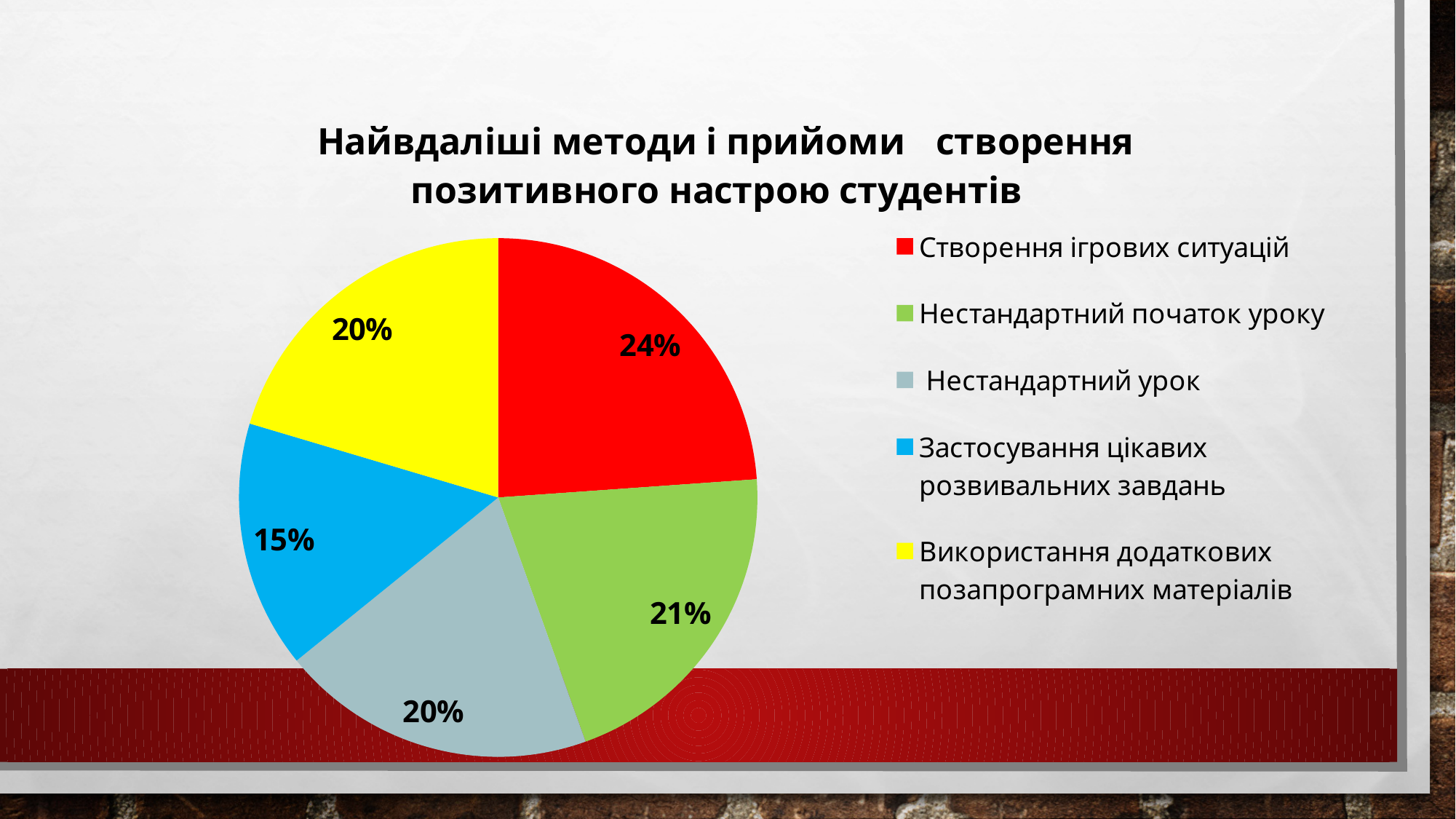
What share of the pie does "Застосування цікавих розвивальних завдань" have? 15% What share of the pie does "Нестандартний початок уроку" have? 21% What is the difference in percentage points between "Створення ігрових ситуацій" and "Застосування цікавих розвивальних завдань"? 9 What colour is the slice for "Використання додаткових позапрограмних матеріалів"? yellow What share of the pie does "Нестандартний урок" have? 20% How many slices does the pie chart have? 5 What share of the pie does "Створення ігрових ситуацій" have? 24% Which category has the smallest share of the pie? Застосування цікавих розвивальних завдань Which is larger: the share for "Нестандартний початок уроку" or the share for "Нестандартний урок"? Нестандартний початок уроку What kind of chart is shown on the slide? pie chart Which category has the largest share of the pie? Створення ігрових ситуацій How many entries does the legend list? 5